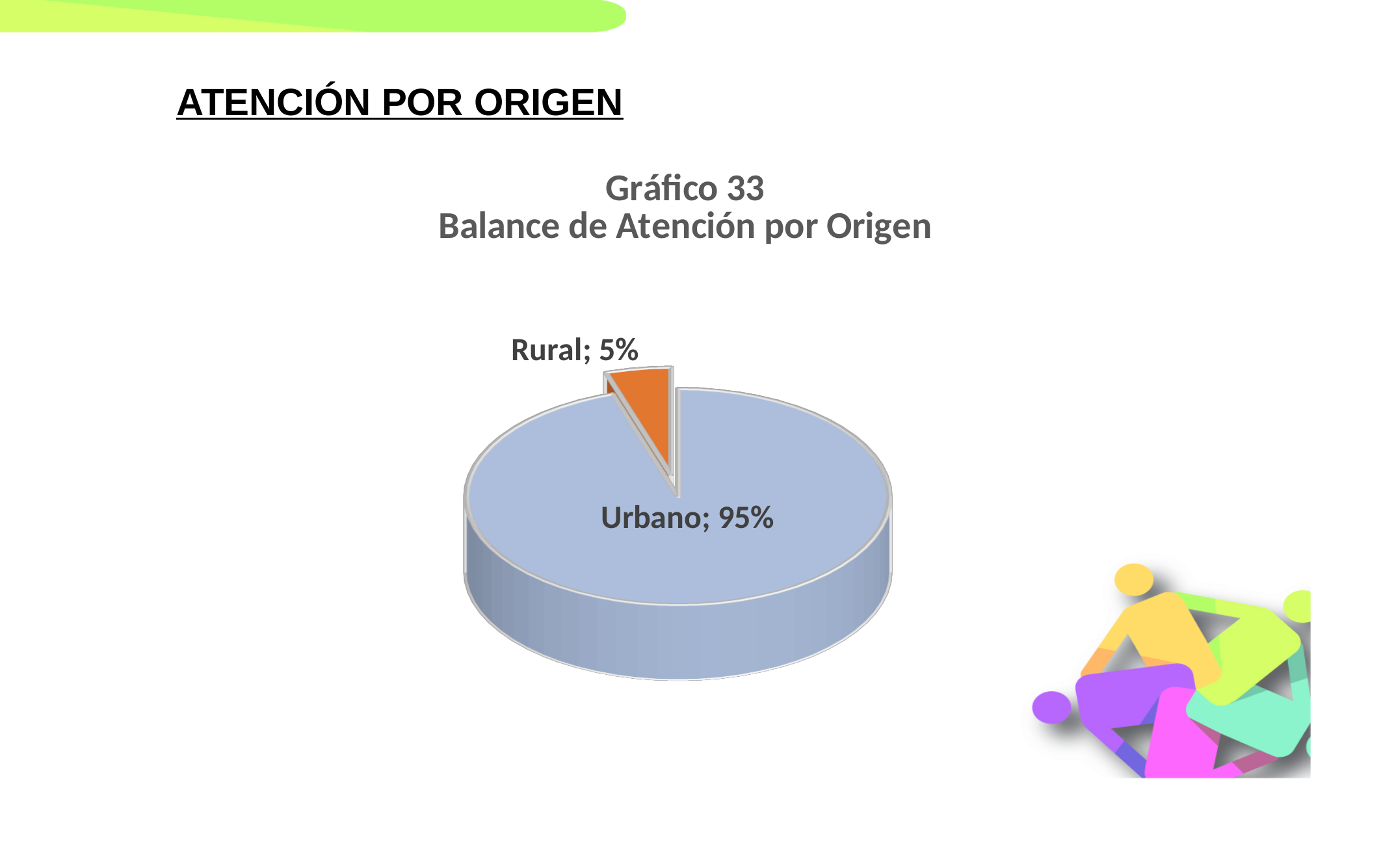
What is the difference in percentage points between the Urbano and Rural slices? 90 Which category has the largest share of the pie? Urbano What kind of chart is shown on the slide? Pie chart What percentage does the Urbano slice represent? 95% How many slices does the pie chart have? 2 What is the title of the chart? Gráfico 33 Balance de Atención por Origen Which is larger, the Rural slice or the Urbano slice? Urbano What is the combined share of the Rural and Urbano slices? 100% Which category has the smallest share of the pie? Rural What percentage does the Rural slice represent? 5% What colour is the Rural slice? Orange